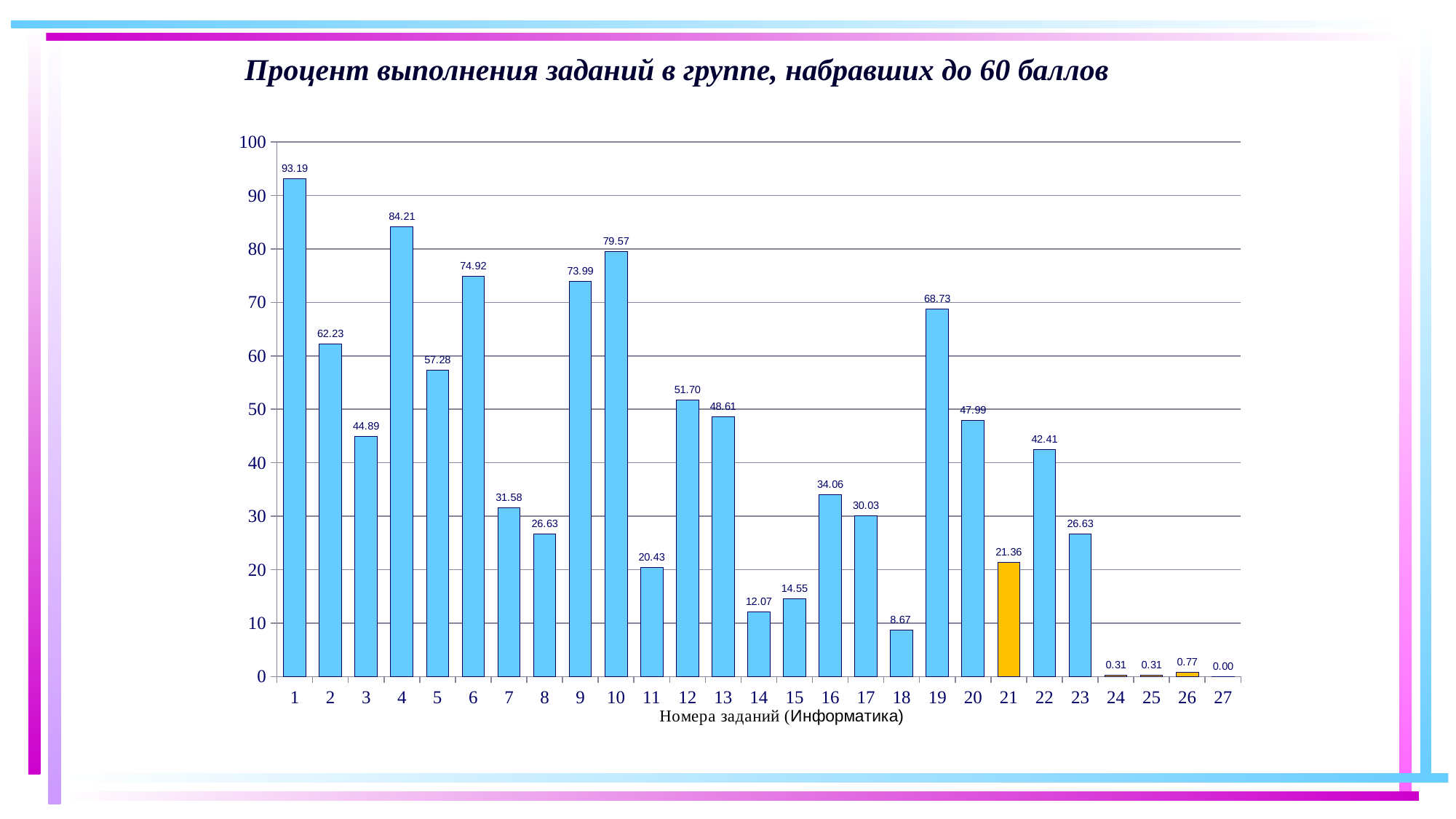
Is the value for task 6 greater or less than 70? greater What kind of chart is shown on the slide? bar chart Which task number has the highest value? 1 What is the difference between the values for task 10 and task 9? 5.58 What is the value for task 21, the orange bar? 21.36 What is the value for task 19? 68.73 What is the difference between the values for task 1 and task 4? 8.98 What is the title of the chart? Процент выполнения заданий в группе, набравших до 60 баллов How many task numbers are shown on the x axis? 27 Which has a larger value, task 12 or task 13? task 12 Which task number has the lowest value? 27 What is the value for task 1? 93.19